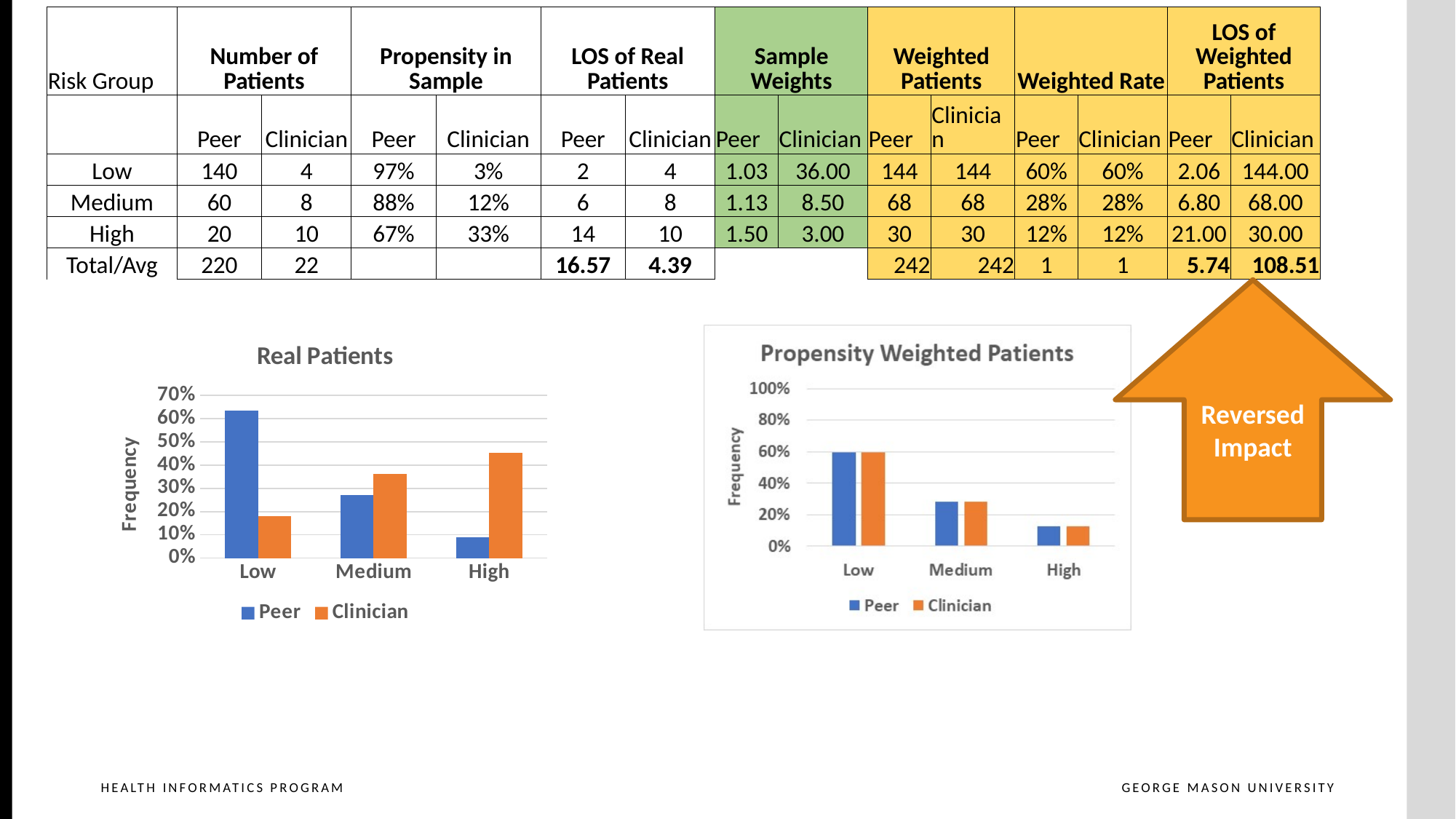
In the "Real Patients" chart, is the Clinician value for High greater or less than 40%? greater What kind of chart is the "Real Patients" chart? bar chart In the "Propensity Weighted Patients" chart, what is the Peer value for Low? 60% In the "Real Patients" chart, for the Low category, which is larger: Peer or Clinician? Peer How many series does the legend of the "Real Patients" chart list? 2 In the "Real Patients" chart, which category has the highest Clinician value? High In the "Propensity Weighted Patients" chart, do the Peer values rise or fall from Low to High? fall In the "Real Patients" chart, which category has the highest Peer value? Low In the "Real Patients" chart, which category has the lowest Peer value? High In the "Real Patients" chart, is the Peer value for Low greater or less than 60%? greater What is the y-axis title of the "Real Patients" chart? Frequency How many risk group categories are shown on the x axis of the "Propensity Weighted Patients" chart? 3